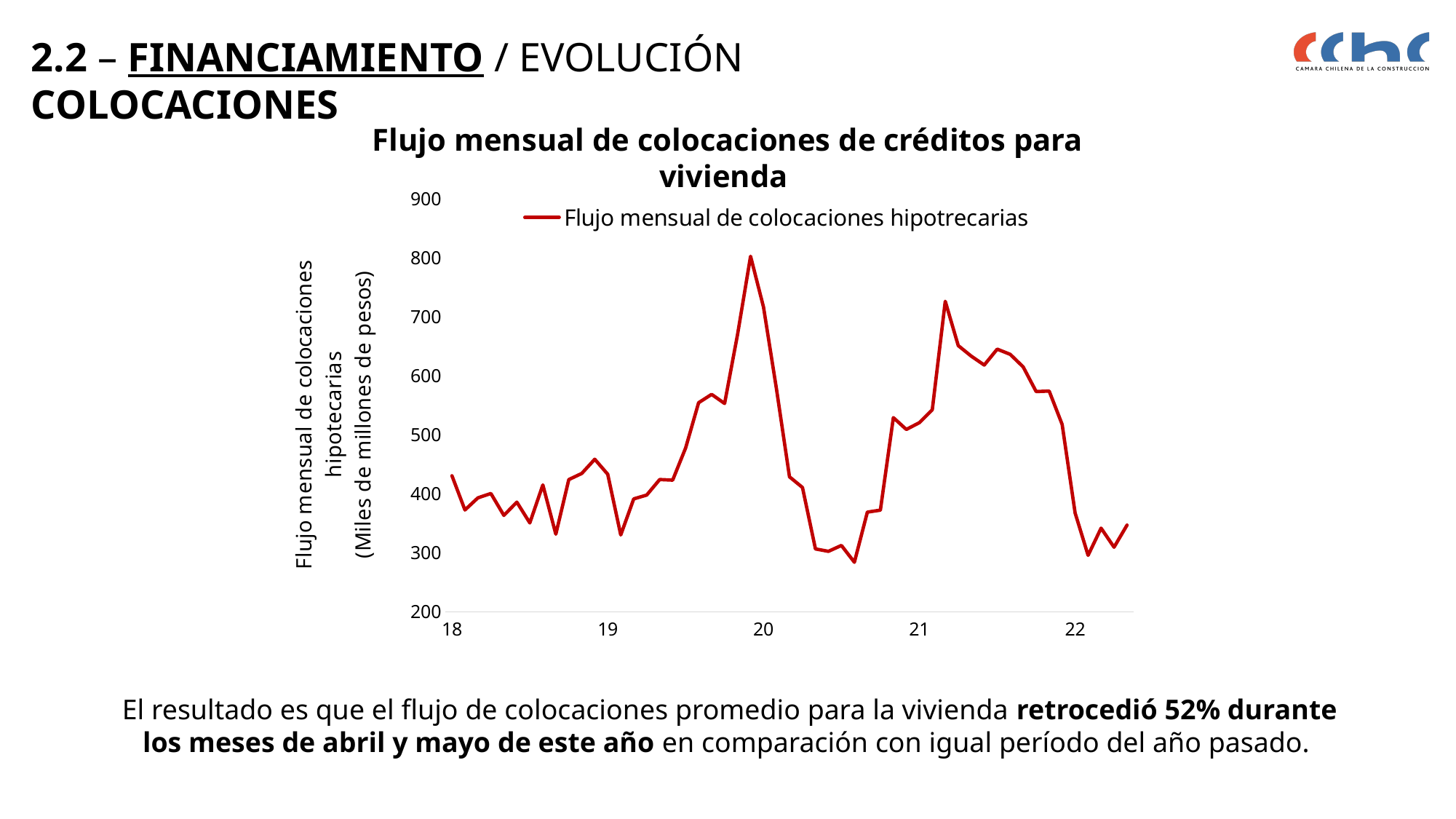
Near which x-axis label does the line reach its highest value? 20 Is the value of the line at the x-axis label 21 greater or less than 400? greater Is the peak value of the line near the x-axis label 20 greater or less than 700? greater What is the title of the chart? Flujo mensual de colocaciones de créditos para vivienda How many series does the chart legend list? 1 What is the legend entry for the plotted line? Flujo mensual de colocaciones hipotrecarias Is the value of the line at the x-axis label 22 greater or less than 400? less Which is larger: the peak of the line near the x-axis label 20 or the peak just after the x-axis label 21? the peak near 20 Does the line rise or fall between the x-axis labels 21 and 22? fall What kind of chart is shown on the slide? line chart